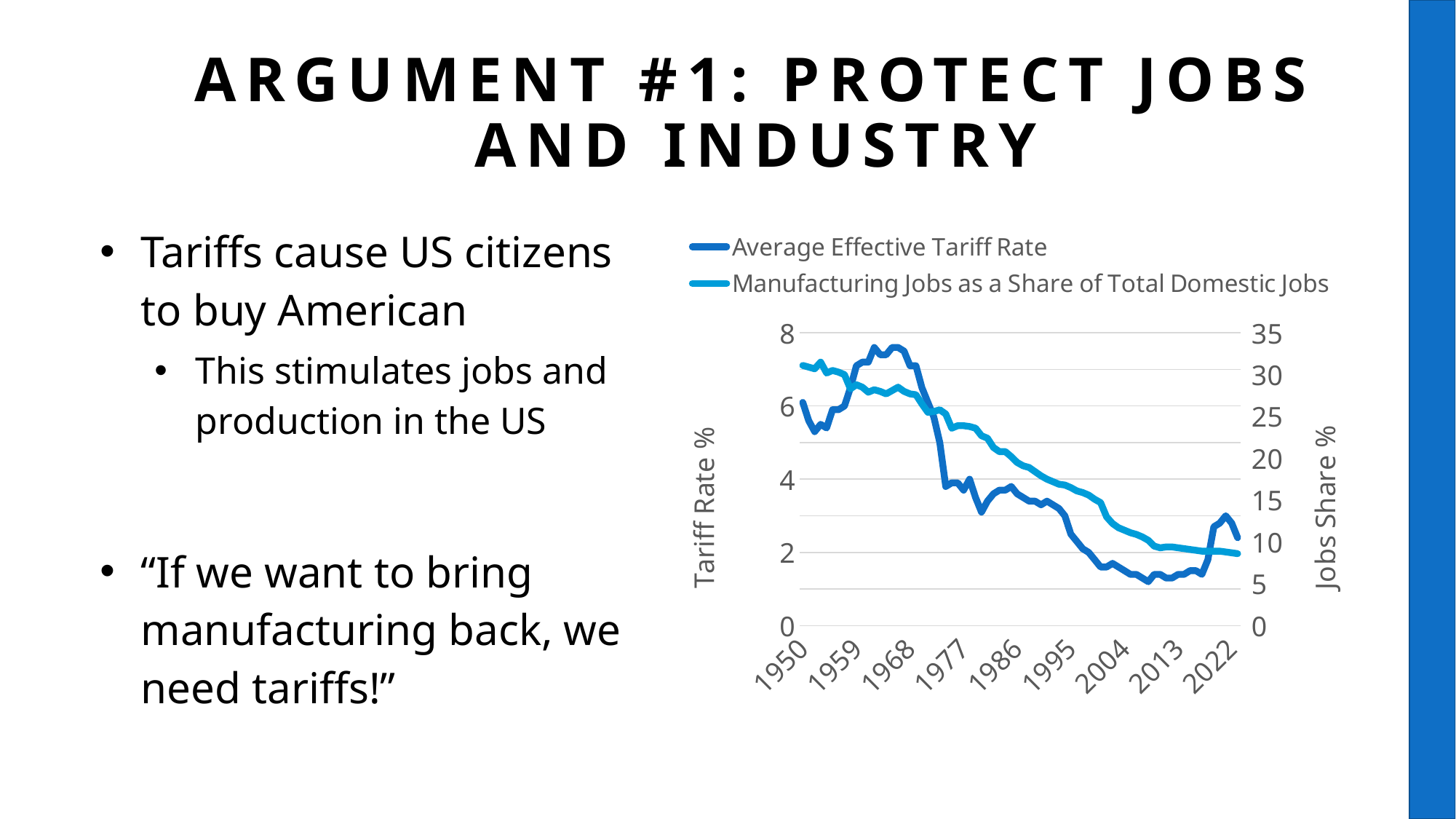
What is the title of the left vertical axis of the chart? Tariff Rate % How many year labels are shown on the x axis of the chart? 9 How many series does the chart's legend list? 2 What are the two series named in the chart's legend? Average Effective Tariff Rate; Manufacturing Jobs as a Share of Total Domestic Jobs What kind of chart is shown on the slide? line chart Is the Manufacturing Jobs as a Share of Total Domestic Jobs value in 2022 greater or less than 15? less Is the Manufacturing Jobs as a Share of Total Domestic Jobs value in 1950 greater or less than 25? greater Does the Manufacturing Jobs as a Share of Total Domestic Jobs line rise or fall from 1950 to 2022? fall Does the Average Effective Tariff Rate line rise or fall overall from 1968 to 2013? fall Is the Average Effective Tariff Rate in 1968 greater or less than 6? greater